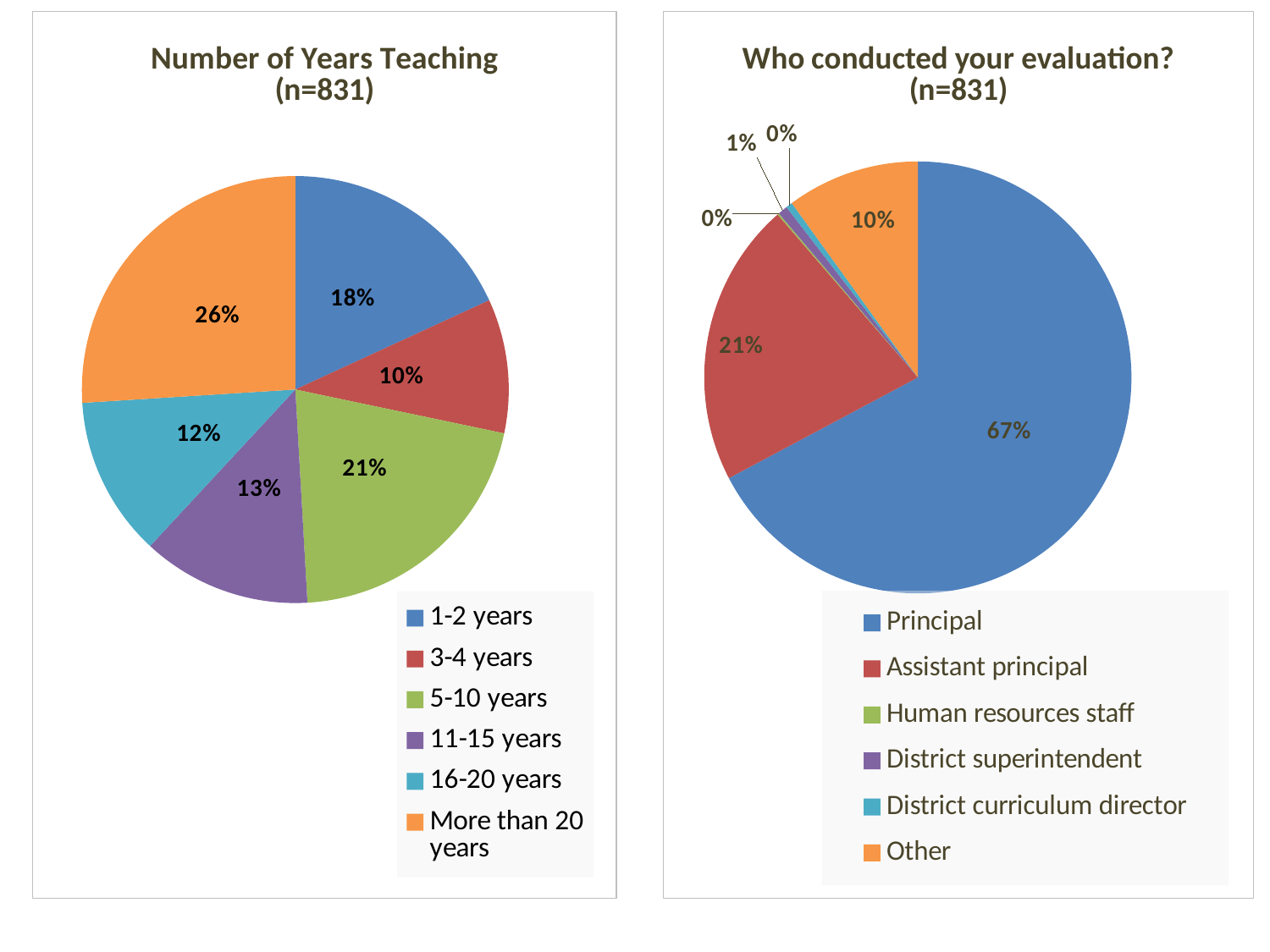
In the 'Number of Years Teaching' chart, which category has the largest share? More than 20 years In the 'Who conducted your evaluation?' chart, what percentage of evaluations were conducted by the principal? 67% How many categories does the legend of the 'Number of Years Teaching' chart list? 6 In the 'Number of Years Teaching' chart, what is the difference in percentage points between the 'More than 20 years' slice and the '11-15 years' slice? 13 In the 'Number of Years Teaching' chart, what percentage of respondents have taught for 5-10 years? 21% In the 'Number of Years Teaching' chart, what share of respondents have taught for 1-2 years? 18% In the 'Who conducted your evaluation?' chart, what is the difference in percentage points between the 'Principal' slice and the 'Other' slice? 57 What sample size (n) is shown in the title of the 'Who conducted your evaluation?' chart? n=831 What type of chart is 'Who conducted your evaluation?'? Pie chart In the 'Number of Years Teaching' chart, which is larger: the share for 16-20 years or the share for 1-2 years? 1-2 years In the 'Who conducted your evaluation?' chart, what share of evaluations were conducted by an assistant principal? 21% In the 'Number of Years Teaching' chart, which category has the smallest share? 3-4 years